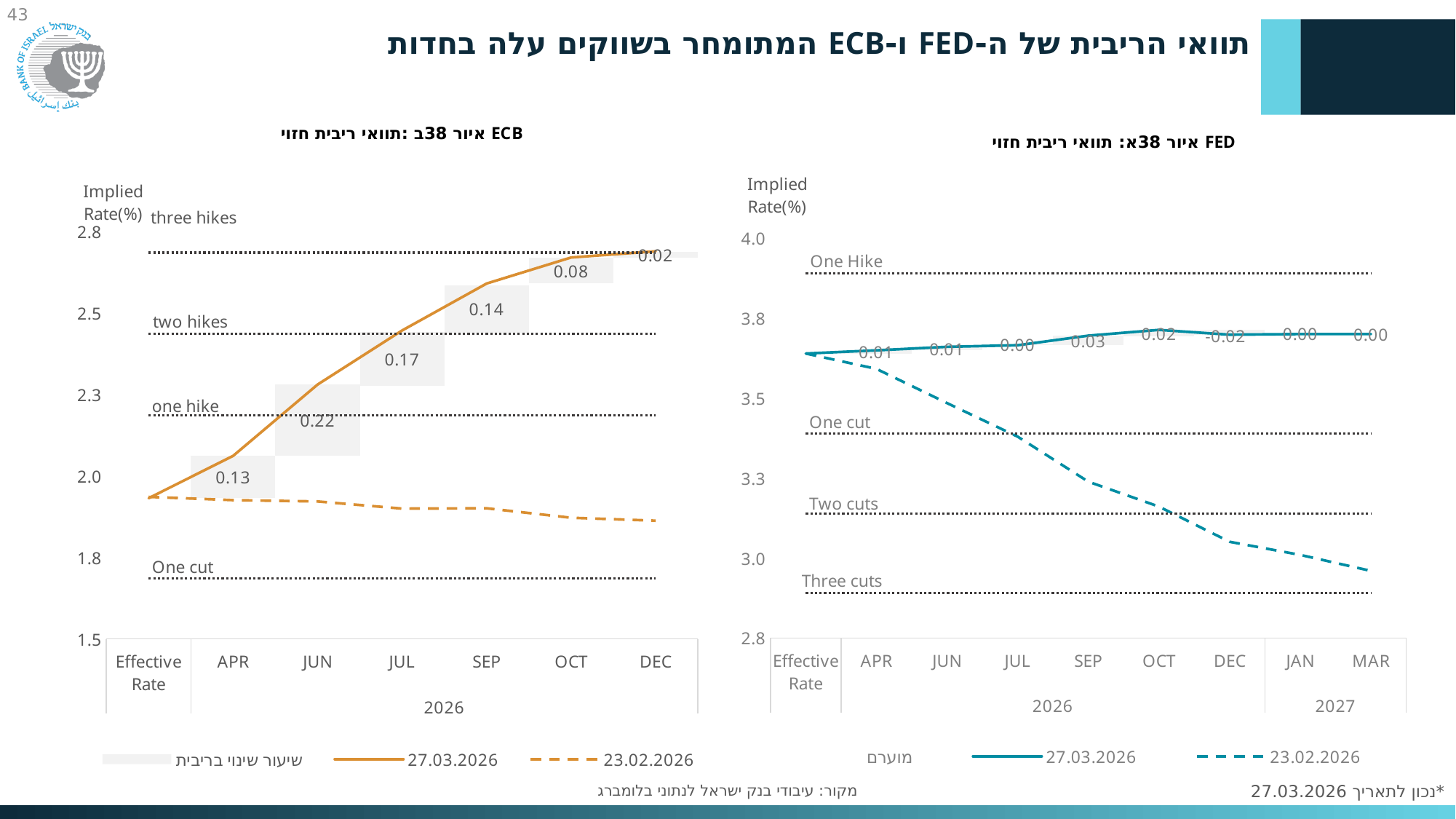
In the FED chart (right), what is the rate change label shown for DEC 2026? -0.02 In the ECB chart (left), is the 27.03.2026 line at DEC greater or less than 2.5? greater In the FED chart (right), what is the rate change label shown for SEP 2026? 0.03 In the ECB chart (left), does the solid 27.03.2026 line rise or fall from the Effective Rate to DEC? rise In the ECB chart (left), what is the difference between the rate change labels for JUN and APR? 0.09 In the ECB chart (left), what is the rate change label shown for JUN 2026? 0.22 In the ECB chart (left), how many months are shown on the x axis after the Effective Rate? 6 In the FED chart (right), is the dashed 23.02.2026 line at MAR 2027 greater or less than 3.0? less In the ECB chart (left), which month has the highest rate change label? JUN In the ECB chart (left), which month has the lowest rate change label? DEC What kind of chart is the FED chart (right)? line chart In the FED chart (right), does the dashed 23.02.2026 line rise or fall from the Effective Rate to MAR 2027? fall